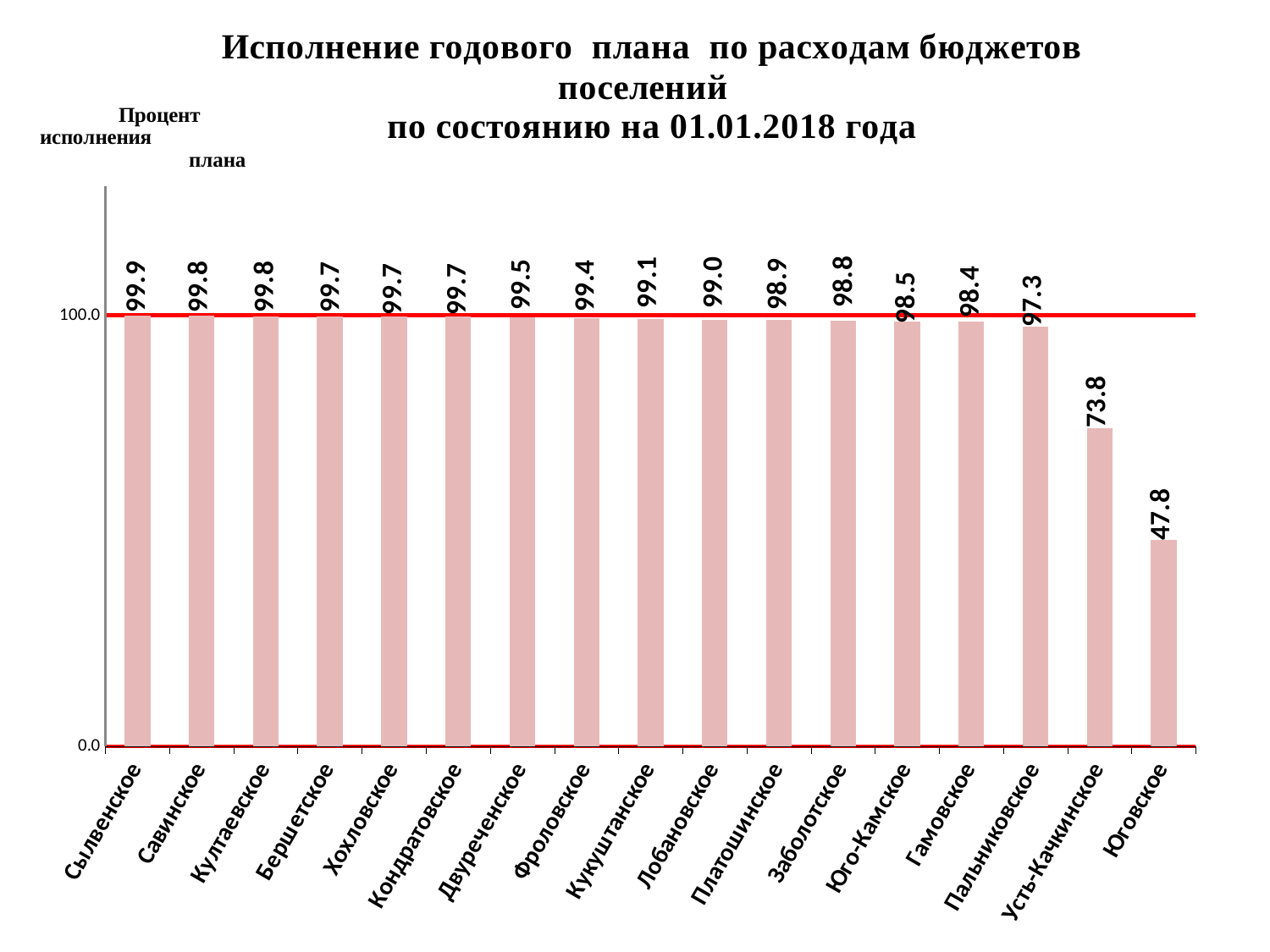
What type of chart is shown on the slide? bar chart What is the difference between the values for Усть-Качкинское and Юговское? 26.0 Which settlement has the highest value on the chart? Сылвенское Which is larger, the value for Гамовское or the value for Усть-Качкинское? Гамовское Do the values rise or fall moving from left to right along the x axis? fall What is the value for Сылвенское? 99.9 What is the value for Юговское? 47.8 At what value is the horizontal red reference line drawn on the chart? 100.0 What is the value for Пальниковское? 97.3 What is the value for Усть-Качкинское? 73.8 Which settlement has the lowest value on the chart? Юговское How many settlements (categories) are plotted on the chart? 17